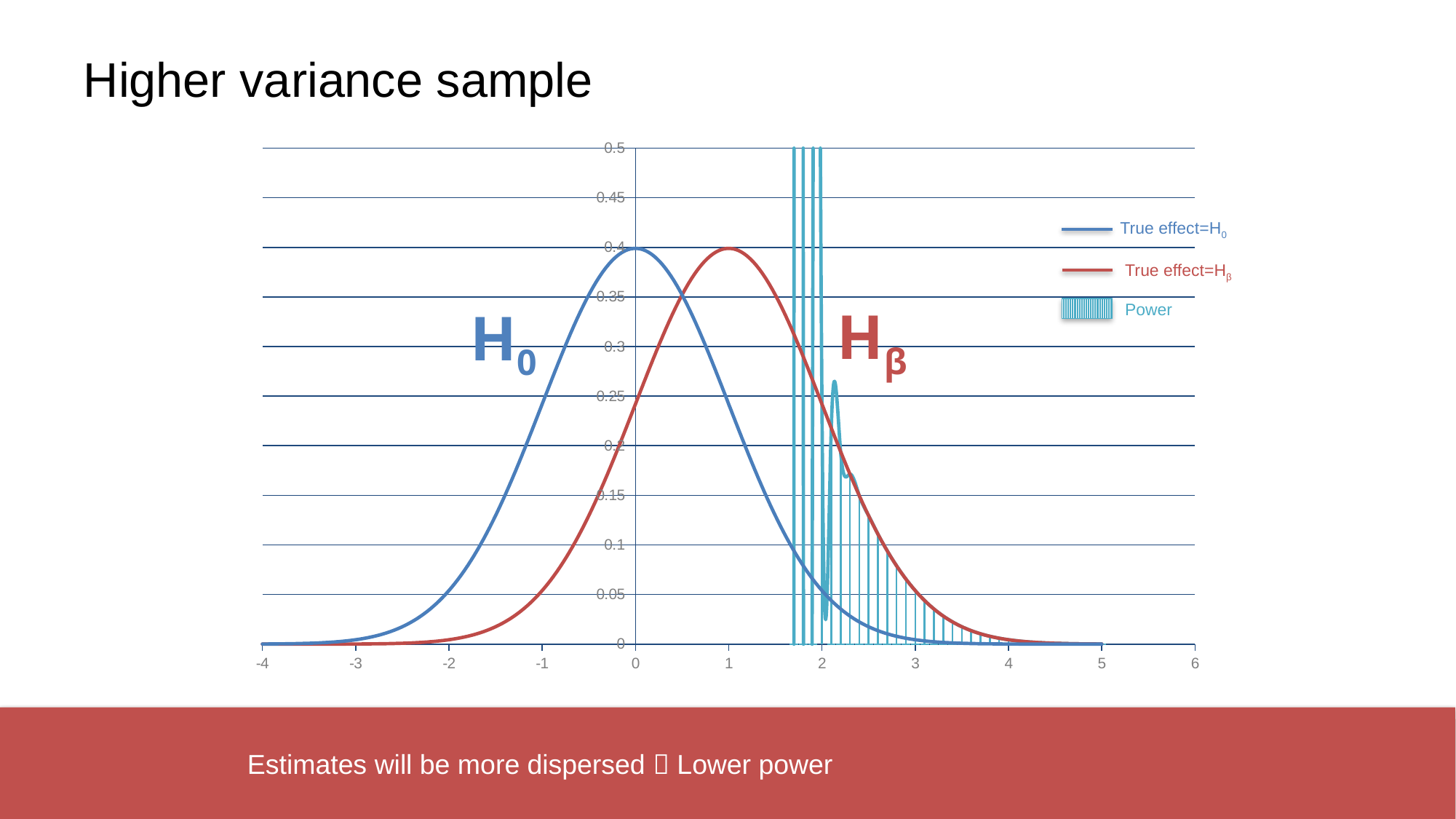
What is the highest value shown on the y axis? 0.5 How many series does the legend list? 3 What is the title of the slide containing the chart? Higher variance sample Does the red 'True effect=Hβ' curve rise or fall as x goes from 1 to 4? fall At which x value does the red 'True effect=Hβ' curve reach its peak? 1 Is the value of the red 'True effect=Hβ' curve at x=3 greater or less than 0.1? less Is the value of the blue 'True effect=H0' curve at x=2 greater or less than 0.1? less Is the peak value of the blue 'True effect=H0' curve greater or less than 0.3? greater At x=-1, which curve is higher, the blue 'True effect=H0' curve or the red 'True effect=Hβ' curve? True effect=H0 At x=2, which curve is higher, the blue 'True effect=H0' curve or the red 'True effect=Hβ' curve? True effect=Hβ At which x value does the blue 'True effect=H0' curve reach its peak? 0 What kind of chart is shown on the slide? line chart